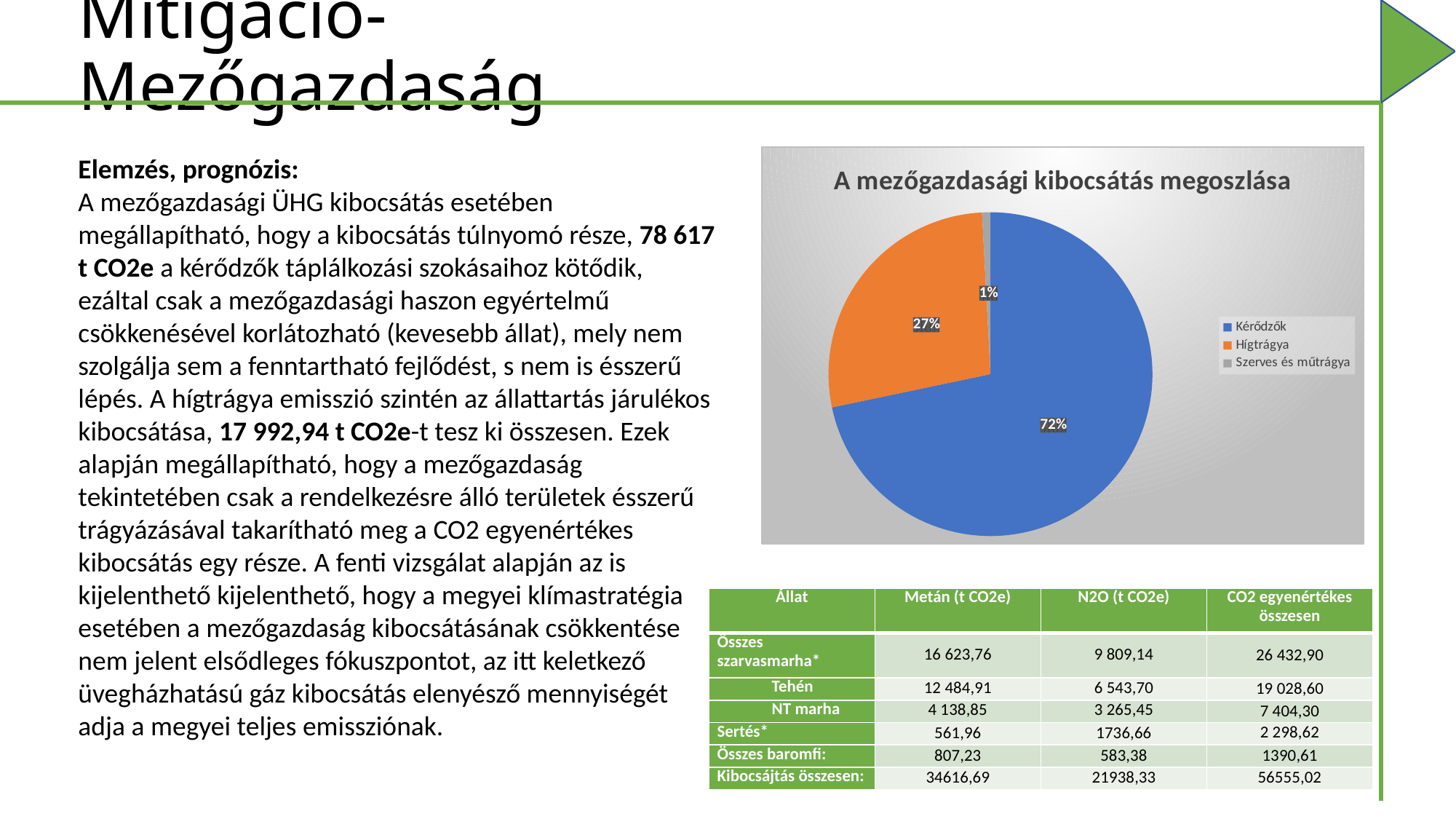
What share of the pie does Kérődzők have? 72% What share of the pie does Hígtrágya have? 27% Which category has the smallest slice of the pie? Szerves és műtrágya What share of the pie does Szerves és műtrágya have? 1% What is the difference in percentage points between the Kérődzők and Hígtrágya slices? 45 How many categories does the pie chart show? 3 What type of chart is shown on the slide? pie chart How many entries does the legend of the pie chart list? 3 What is the title of the pie chart? A mezőgazdasági kibocsátás megoszlása Which slice is larger, Hígtrágya or Szerves és műtrágya? Hígtrágya Which category has the largest slice of the pie? Kérődzők What colour is the Hígtrágya slice in the pie chart? orange